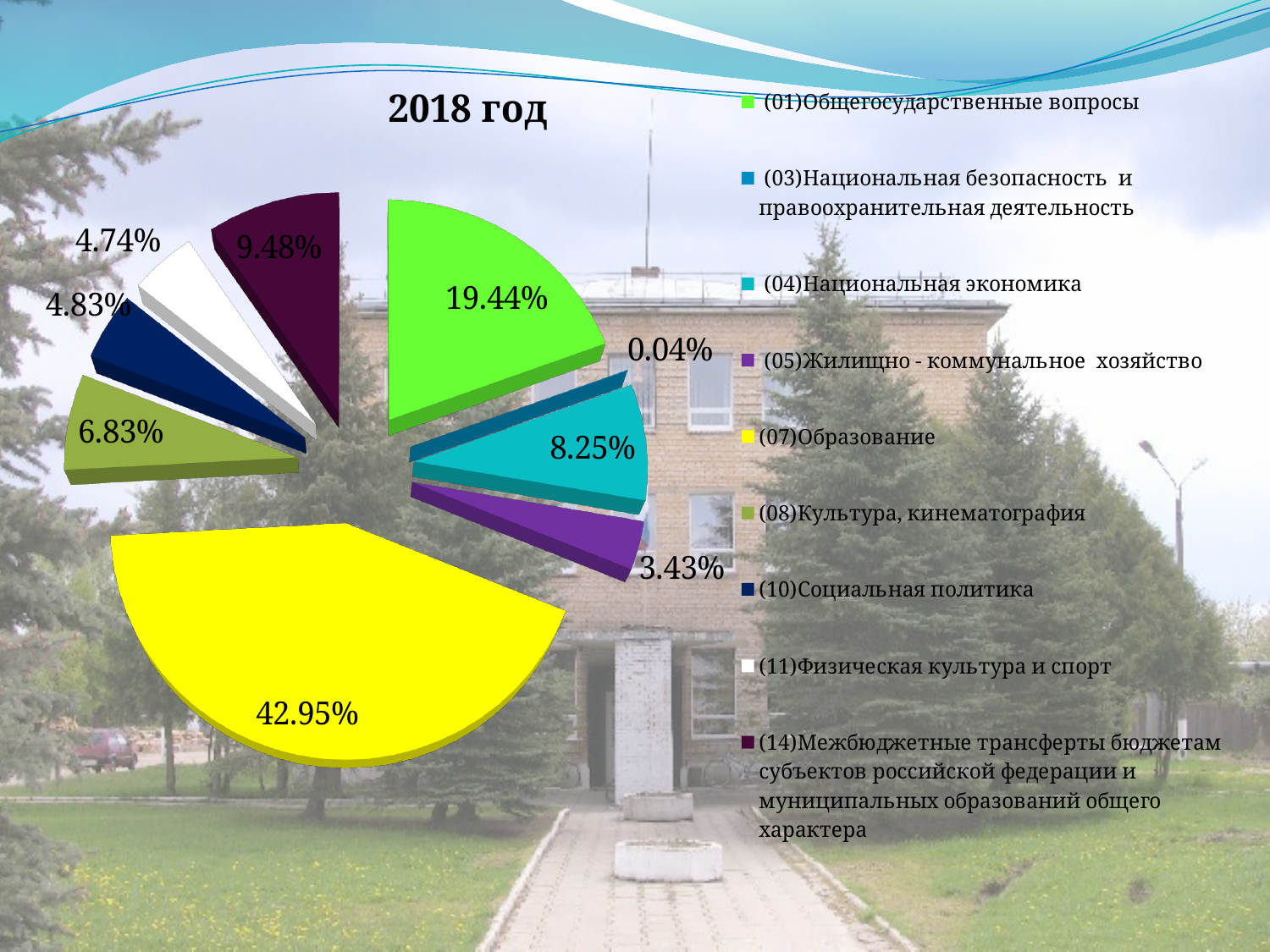
What kind of chart is shown on the slide? pie chart Which category has the smallest share of the pie? (03)Национальная безопасность и правоохранительная деятельность What share of the pie does (04)Национальная экономика have? 8.25% What is the difference in percentage points between (07)Образование and (01)Общегосударственные вопросы? 23.51 What share of the pie does (01)Общегосударственные вопросы have? 19.44% Which has a larger share: (08)Культура, кинематография or (05)Жилищно - коммунальное хозяйство? (08)Культура, кинематография What colour is the slice for (07)Образование? yellow Which category has the largest share of the pie? (07)Образование What share of the pie does (07)Образование have? 42.95% What is the title of the chart? 2018 год How many slices does the pie chart have? 9 What share of the pie does (14)Межбюджетные трансферты бюджетам субъектов российской федерации и муниципальных образований общего характера have? 9.48%